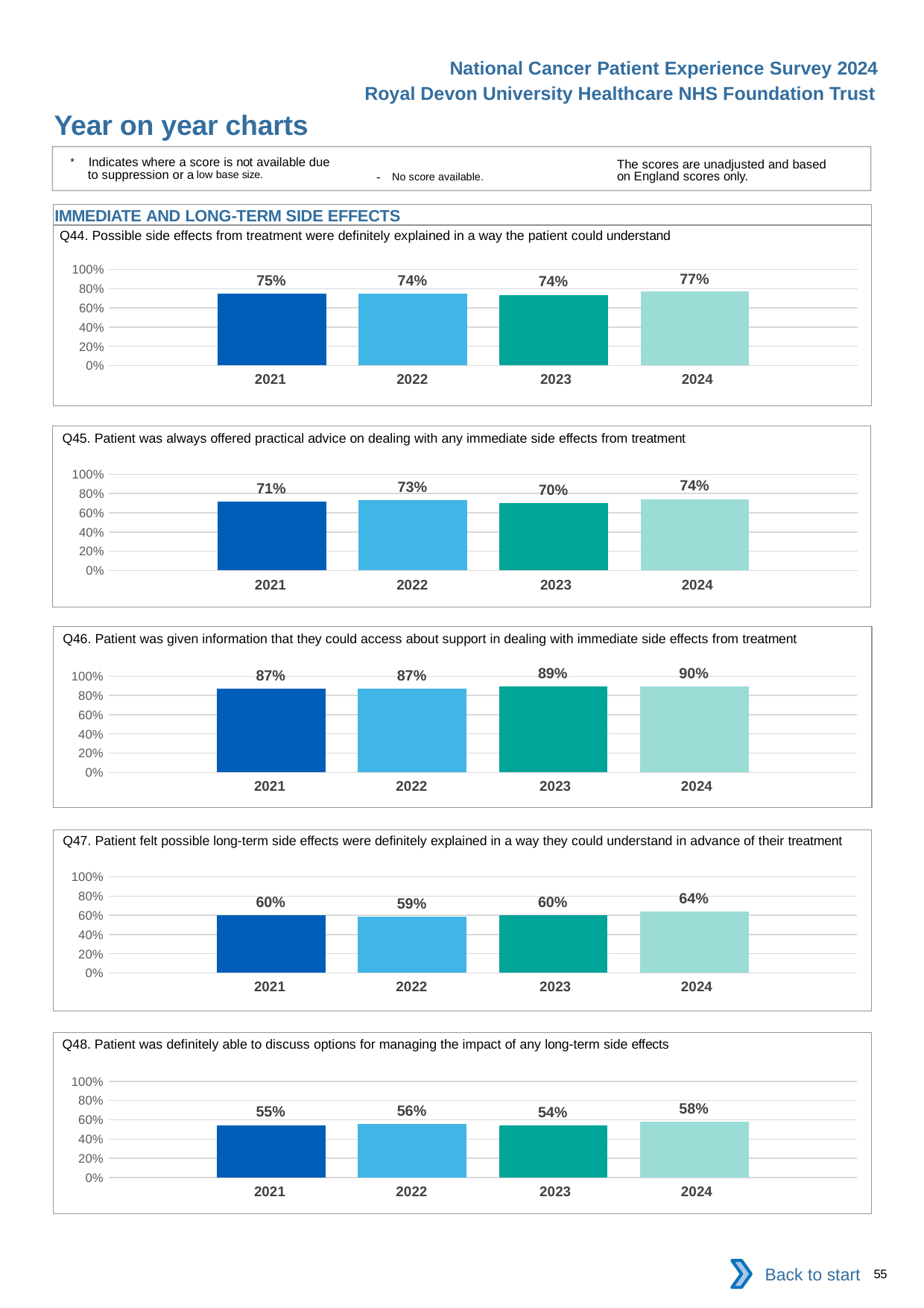
In the Q48 chart, what is the value for 2022? 56% In the Q45 chart, what is the difference between the 2022 and 2023 values? 3% In the Q46 chart, what is the difference between the 2024 and 2021 values? 3% What is the section heading above the Q44 chart? IMMEDIATE AND LONG-TERM SIDE EFFECTS In the Q48 chart, is the value for 2023 greater or less than 60%? less In the Q45 chart, which year has the lowest value? 2023 What type of chart is used for Q46? bar chart In the Q47 chart, is the value for 2022 larger or smaller than the value for 2024? smaller How many years are shown in the Q45 chart? 4 In the Q44 chart, what is the value for 2021? 75% In the Q47 chart, which year has the highest value? 2024 In the Q44 chart, what is the value for 2024? 77%